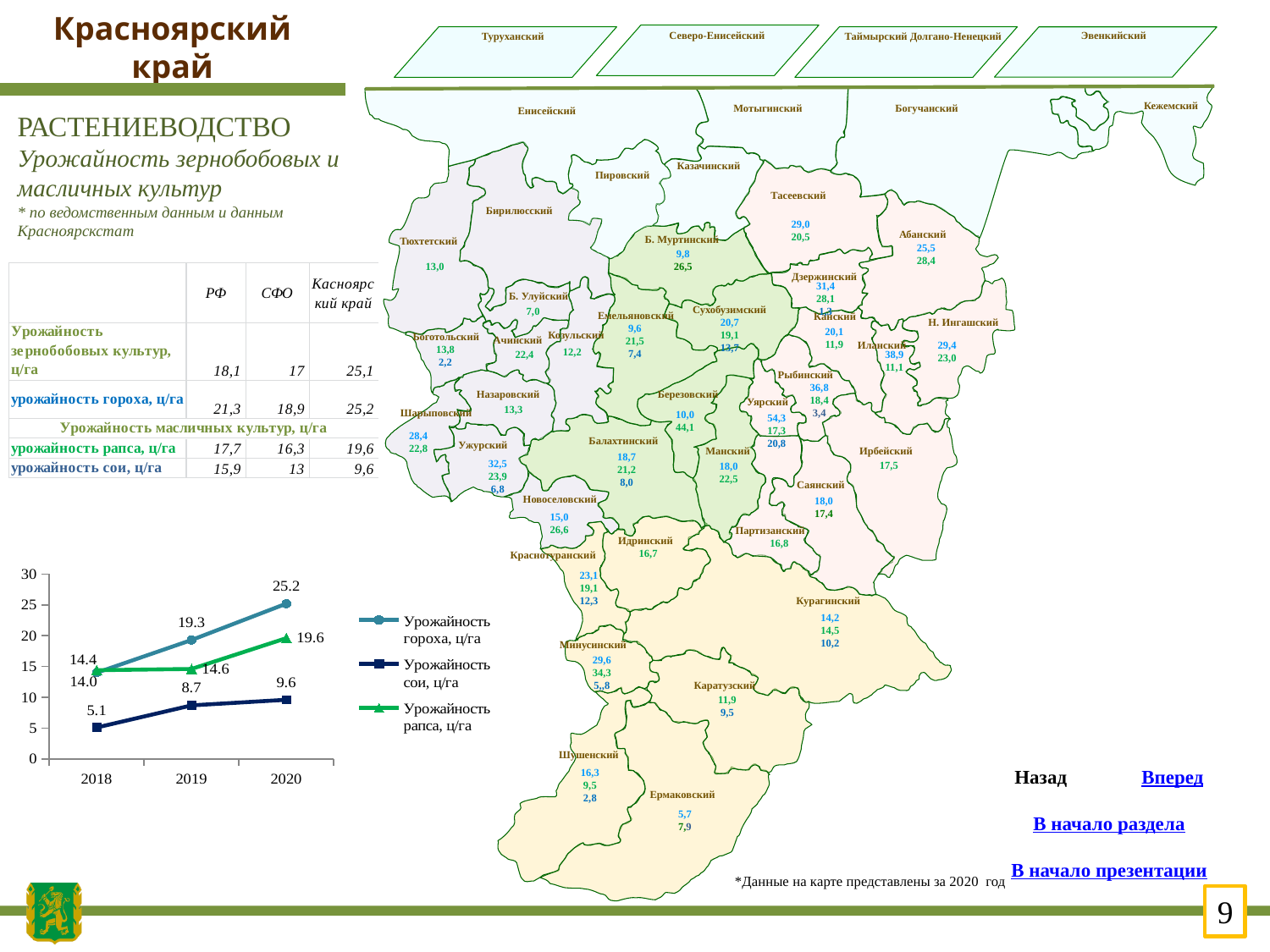
What is the value of Урожайность сои, ц/га in 2018? 5.1 How many years are plotted on the x axis of the chart? 3 What kind of chart is shown on the slide? line chart What is the difference between Урожайность гороха, ц/га in 2020 and in 2018? 11.2 What is the value of Урожайность гороха, ц/га in 2020? 25.2 Is the value of Урожайность рапса, ц/га in 2020 greater or less than 15? greater How many series does the chart legend list? 3 What is the value of Урожайность рапса, ц/га in 2019? 14.6 In which year is Урожайность сои, ц/га lowest? 2018 Does Урожайность сои, ц/га rise or fall from 2018 to 2020? rise In which year is Урожайность гороха, ц/га highest? 2020 Which is larger in 2019: Урожайность гороха, ц/га or Урожайность рапса, ц/га? Урожайность гороха, ц/га